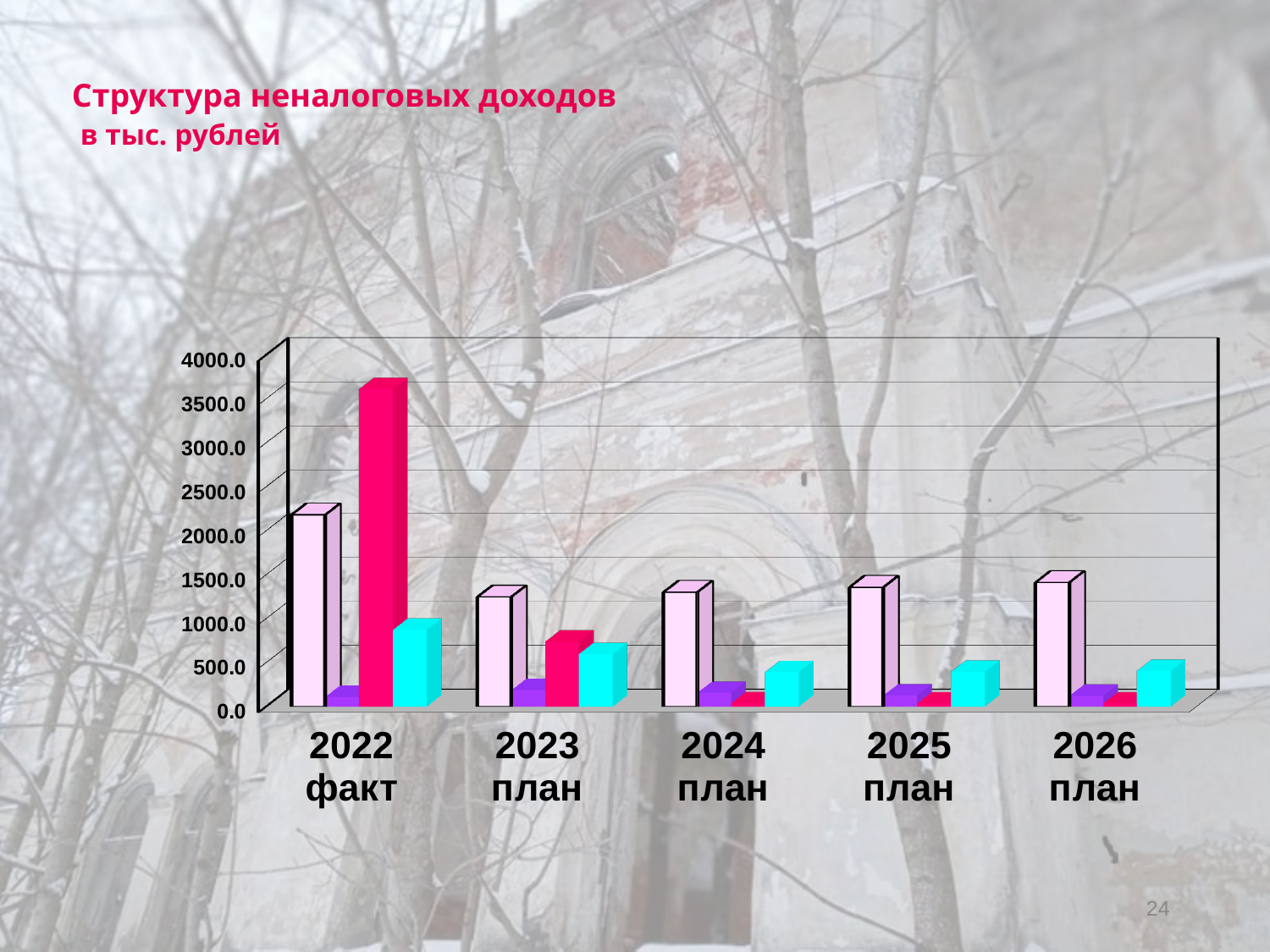
Which category has the tallest bar in the chart? 2022 факт Is the value of the light pink bar for 2023 план greater or less than 1500.0? less Is the value of the purple bar for 2025 план greater or less than 500.0? less How many categories are shown along the x axis? 5 For 2024 план, which is larger: the magenta bar or the cyan bar? the cyan bar Do the magenta bars rise or fall from 2022 факт to 2026 план? fall Is the value of the magenta bar for 2023 план greater or less than 500.0? greater How many bars are plotted for each category? 4 What is the title of the chart? Структура неналоговых доходов в тыс. рублей What kind of chart is shown on the slide? bar chart